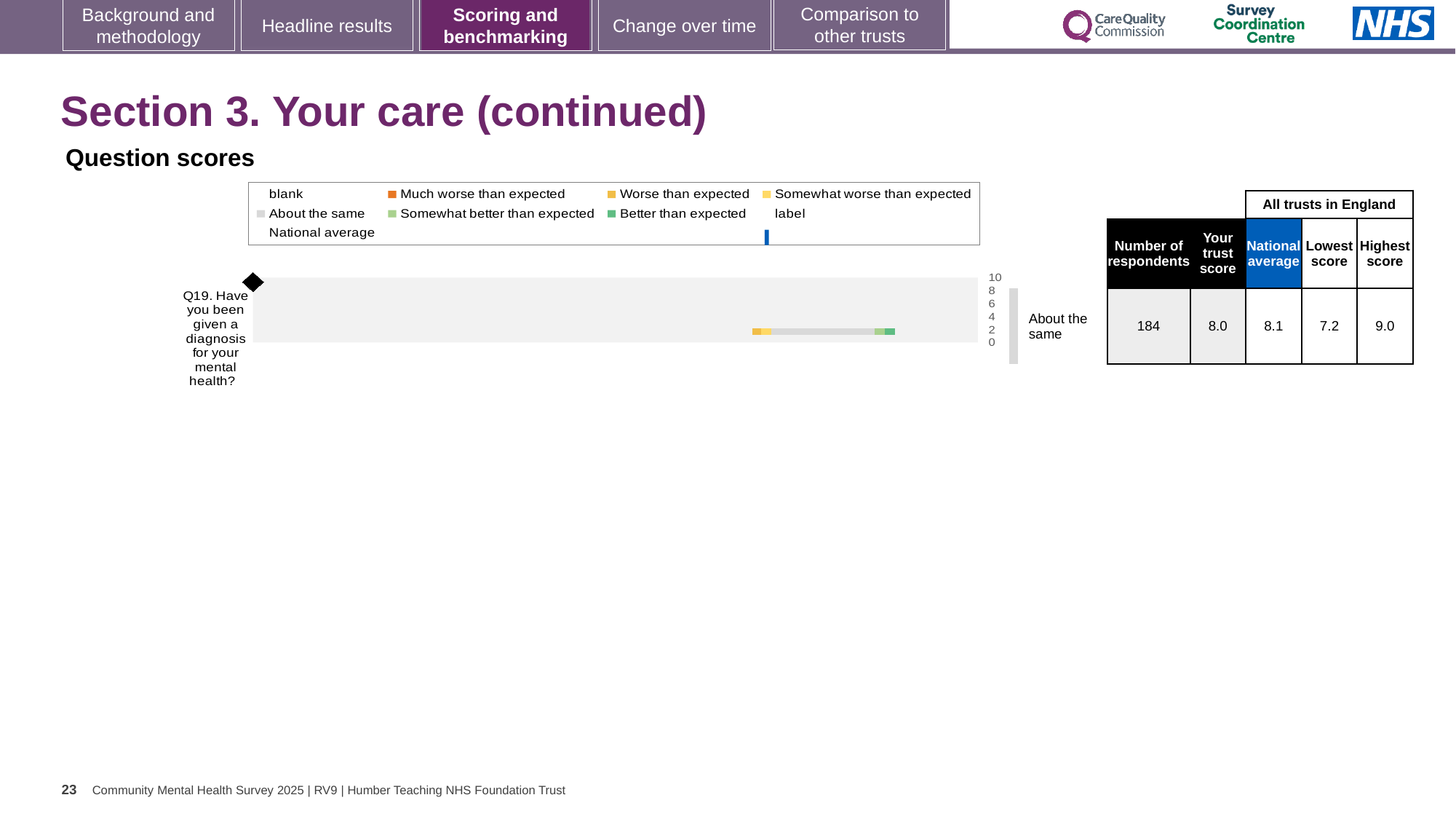
What is the highest score among all trusts in England for Q19? 9.0 What is the number of respondents for Q19? 184 Which is larger for Q19, the trust score or the national average? National average What is the lowest score among all trusts in England for Q19? 7.2 How many questions are plotted on the chart? 1 Which question is plotted on the chart? Q19. Have you been given a diagnosis for your mental health? What is the national average score for Q19? 8.1 What kind of chart is used to show the Q19 question score? bar chart What is the difference between the highest and lowest scores for Q19? 1.8 What is the trust score for Q19? 8.0 What benchmark label is shown next to the Q19 bar? About the same What does the blue vertical line in the legend represent? National average